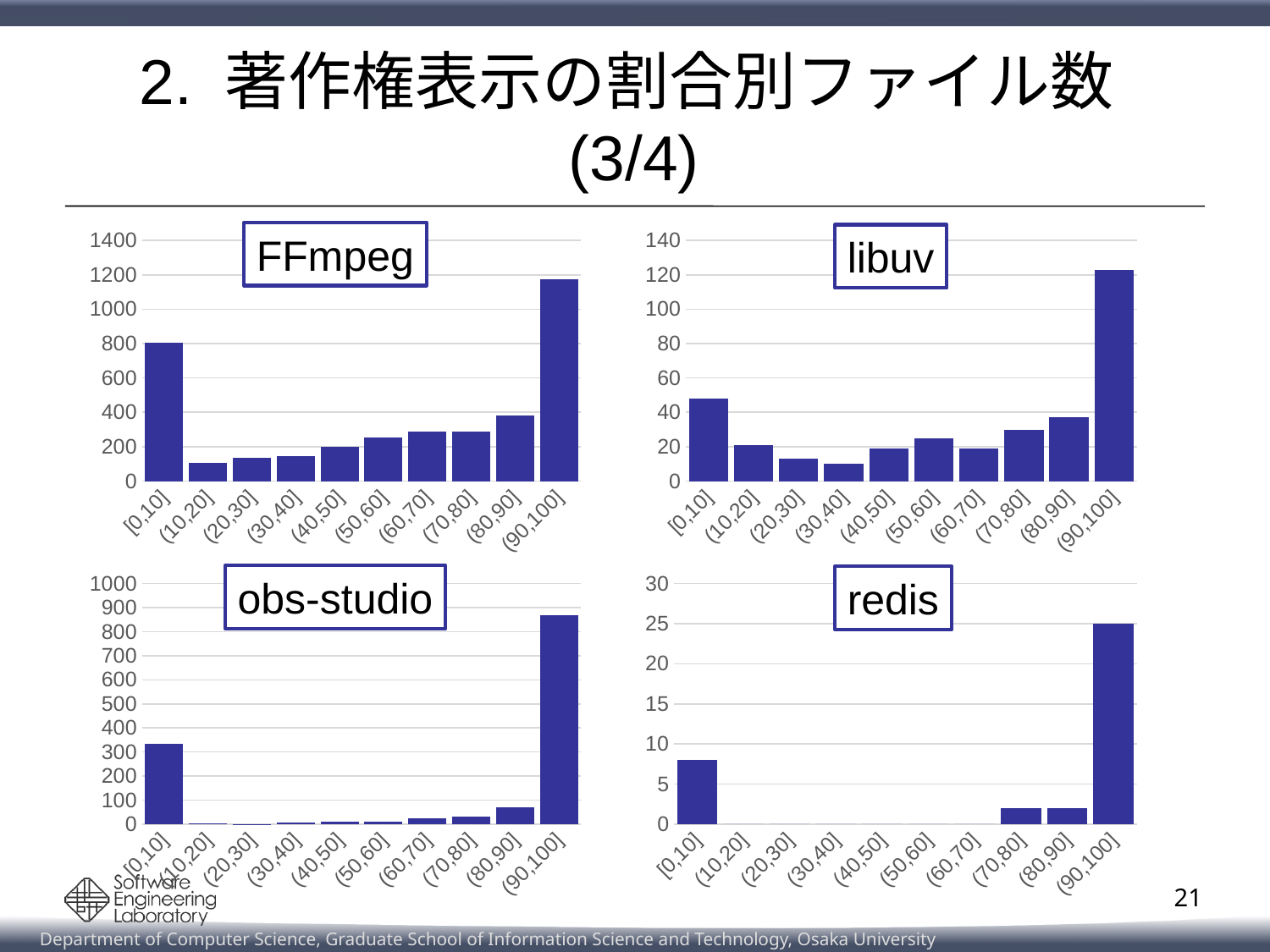
In the obs-studio chart, is the value for [0,10] greater or less than 400? less In the libuv chart, is the value for (90,100] greater or less than 100? greater In the obs-studio chart, which category has the highest value? (90,100] How many charts are shown on the slide? 4 What kind of chart is the FFmpeg chart? bar chart In the redis chart, is the value for [0,10] greater or less than 10? less In the redis chart, what is the value for (90,100]? 25 How many categories are shown on the x axis of the redis chart? 10 In the libuv chart, which is larger, the value for [0,10] or the value for (80,90]? [0,10] In the FFmpeg chart, which category has the highest value? (90,100] In the libuv chart, which category has the lowest value? (30,40]